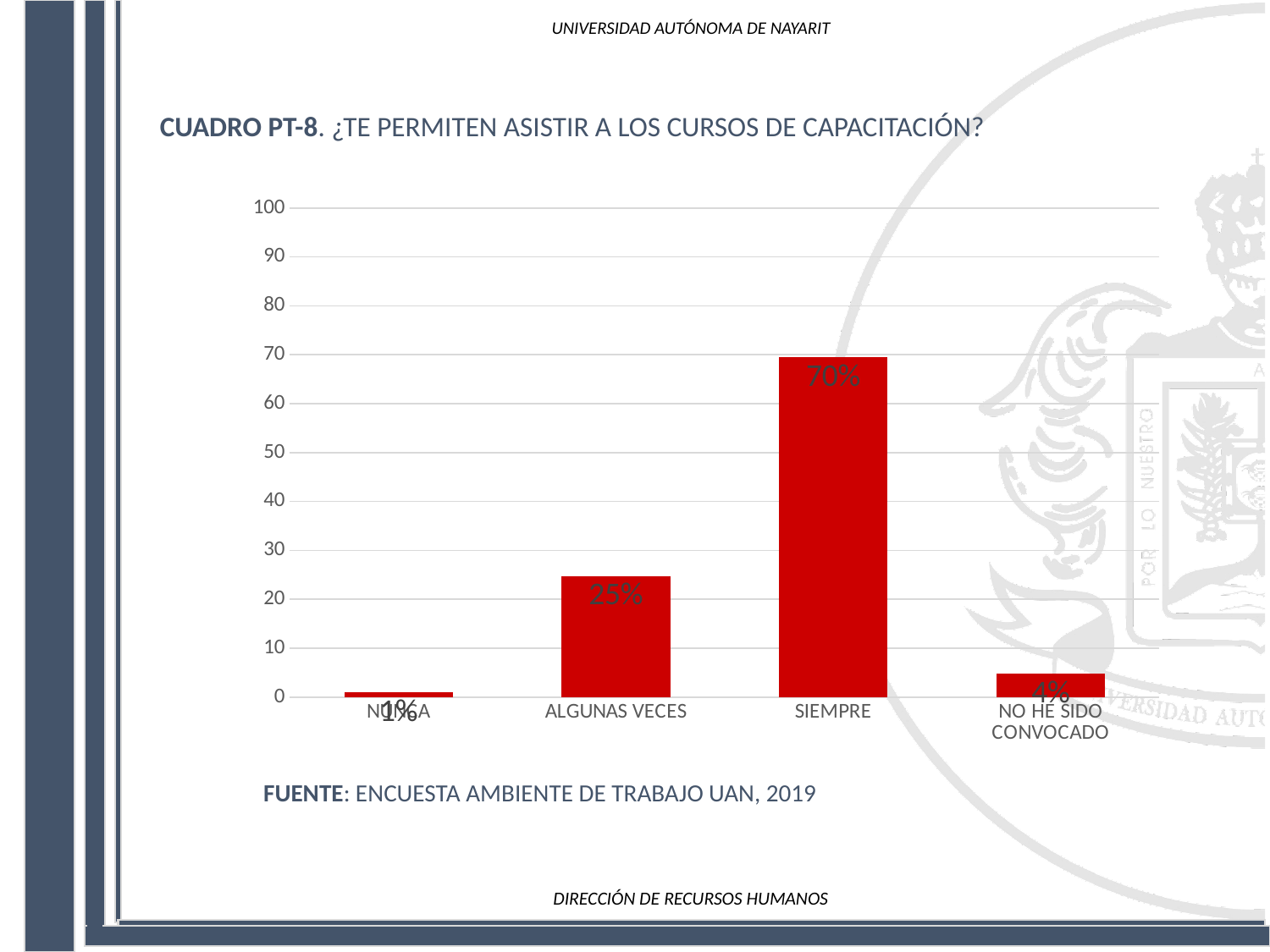
What is the value for NUNCA? 1% What is the value for NO HE SIDO CONVOCADO? 4% Is the value for SIEMPRE greater or less than 60? greater What is the value for ALGUNAS VECES? 25% What is the title of the chart? CUADRO PT-8. ¿TE PERMITEN ASISTIR A LOS CURSOS DE CAPACITACIÓN? What type of chart is shown on the slide? bar chart Which category has the highest value? SIEMPRE Which is larger, the value for ALGUNAS VECES or the value for NO HE SIDO CONVOCADO? ALGUNAS VECES What is the difference between the values for SIEMPRE and ALGUNAS VECES? 45% How many categories are shown on the x axis? 4 What is the value for SIEMPRE? 70% Which category has the lowest value? NUNCA